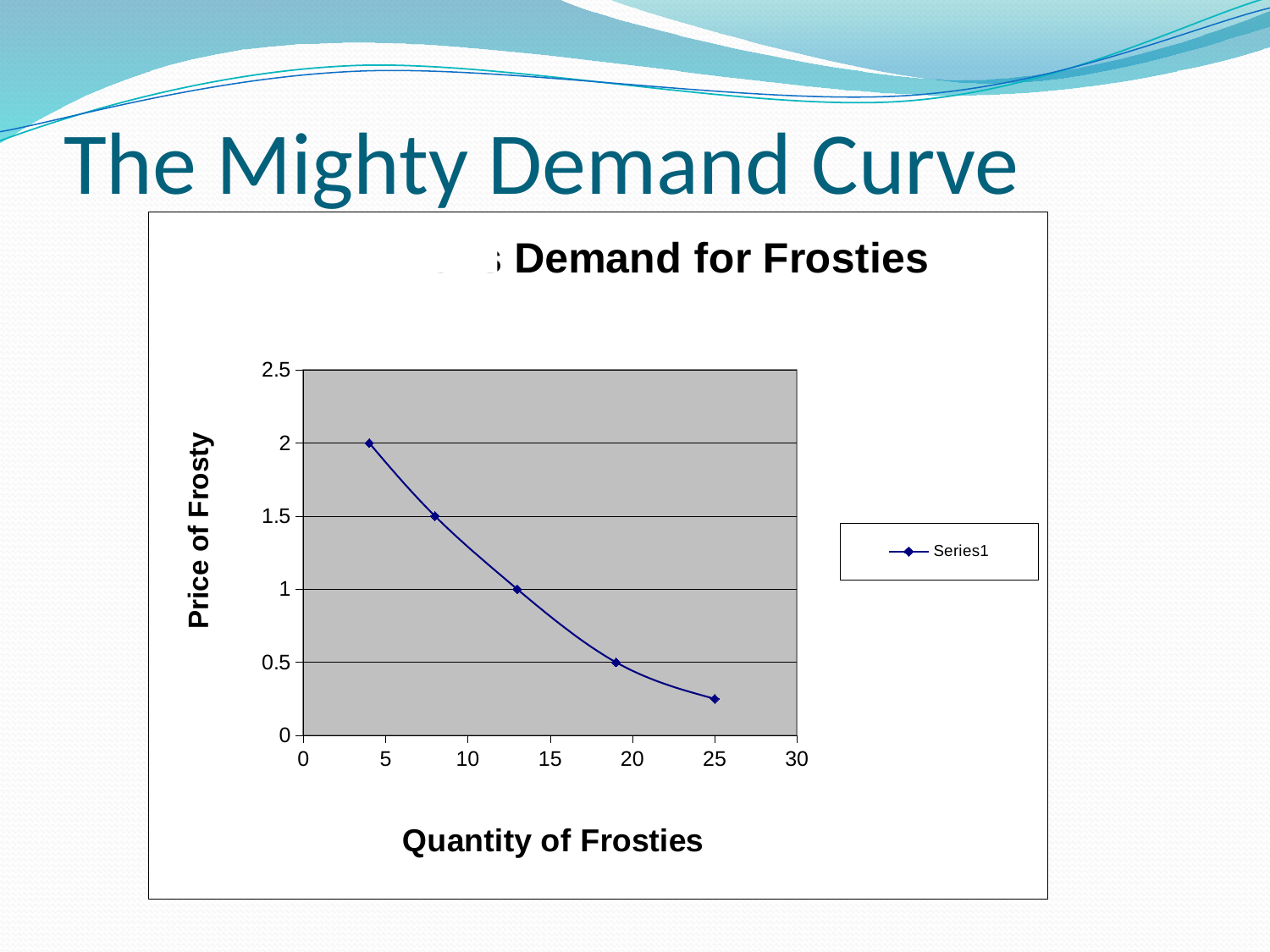
How many series does the legend list? 1 What is the price of the middle (third) point on the curve? 1 Is the price at a quantity of 25 Frosties greater or less than 0.5? less Is the price of the leftmost point greater or less than 1.5? greater What is the difference between the price of the leftmost point and the price of the middle point? 1 As the quantity of Frosties increases along the x axis, does the price rise or fall? fall What is the price of the leftmost (highest) point on the curve? 2 Which point has the highest price, the leftmost or the rightmost? leftmost What is the label of the x axis? Quantity of Frosties What is the label of the y axis? Price of Frosty How many data points are plotted on the demand curve? 5 What kind of chart is shown on the slide? line chart